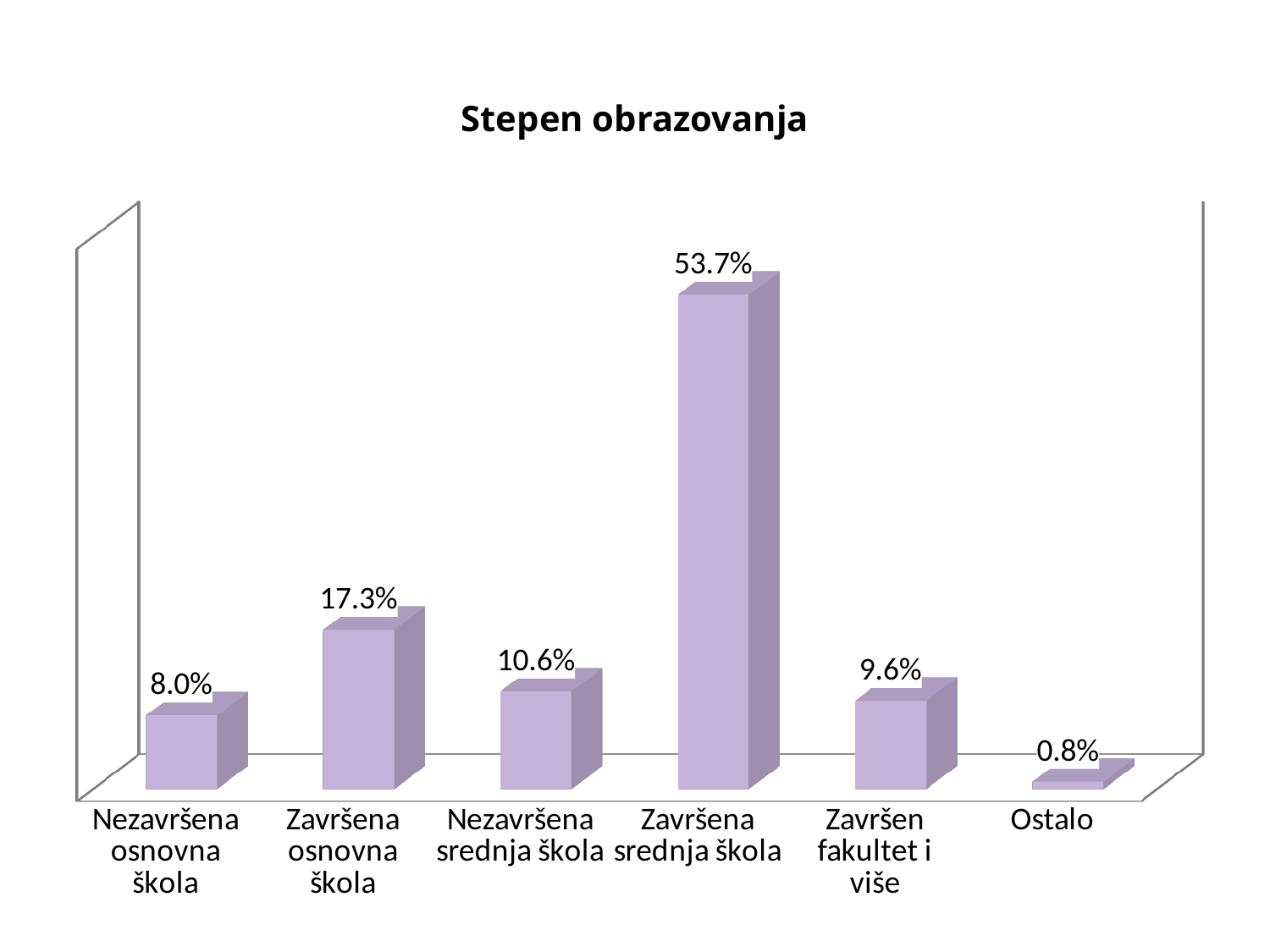
What is the value for Završena srednja škola? 53.7% What is the title of the chart? Stepen obrazovanja Which category has the lowest value? Ostalo What kind of chart is this? Bar chart What is the value for Ostalo? 0.8% What is the value for Završen fakultet i više? 9.6% What is the difference between Završena srednja škola and Završena osnovna škola? 36.4% How many categories are shown in the chart? 6 Which category has the highest value? Završena srednja škola What is the value for Nezavršena osnovna škola? 8.0% Which is larger, Nezavršena srednja škola or Završen fakultet i više? Nezavršena srednja škola What is the difference between Završena osnovna škola and Nezavršena srednja škola? 6.7%